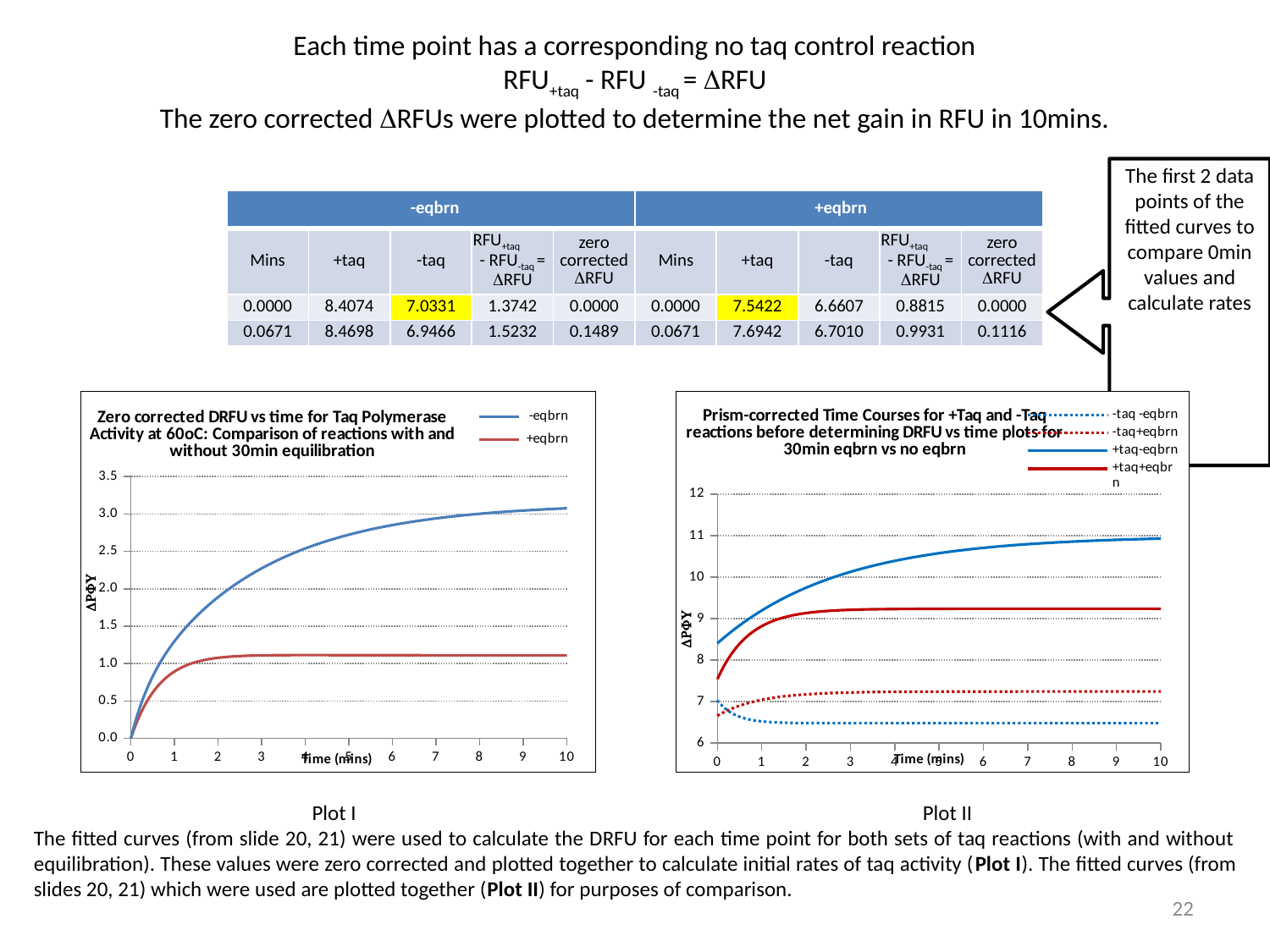
In Plot II, which series has the highest value at 10 mins? +taq-eqbrn In Plot II, is the value of the +taq+eqbrn series at 10 mins greater or less than 8? greater In Plot II, does the -taq -eqbrn series rise or fall as time increases from 0 to 10 mins? fall In Plot I, is the value of the +eqbrn series at 10 mins greater or less than 1.5? less How many series does the legend of Plot II list? 4 In Plot II, is the value of the +taq-eqbrn series at 10 mins greater or less than 10? greater In Plot I, which series reaches the higher value at 10 mins, -eqbrn or +eqbrn? -eqbrn What kind of chart is Plot I? line chart In Plot I, does the -eqbrn series rise or fall as time increases from 0 to 10 mins? rise What is the x-axis title of Plot I? Time (mins) How many series does the legend of Plot I list? 2